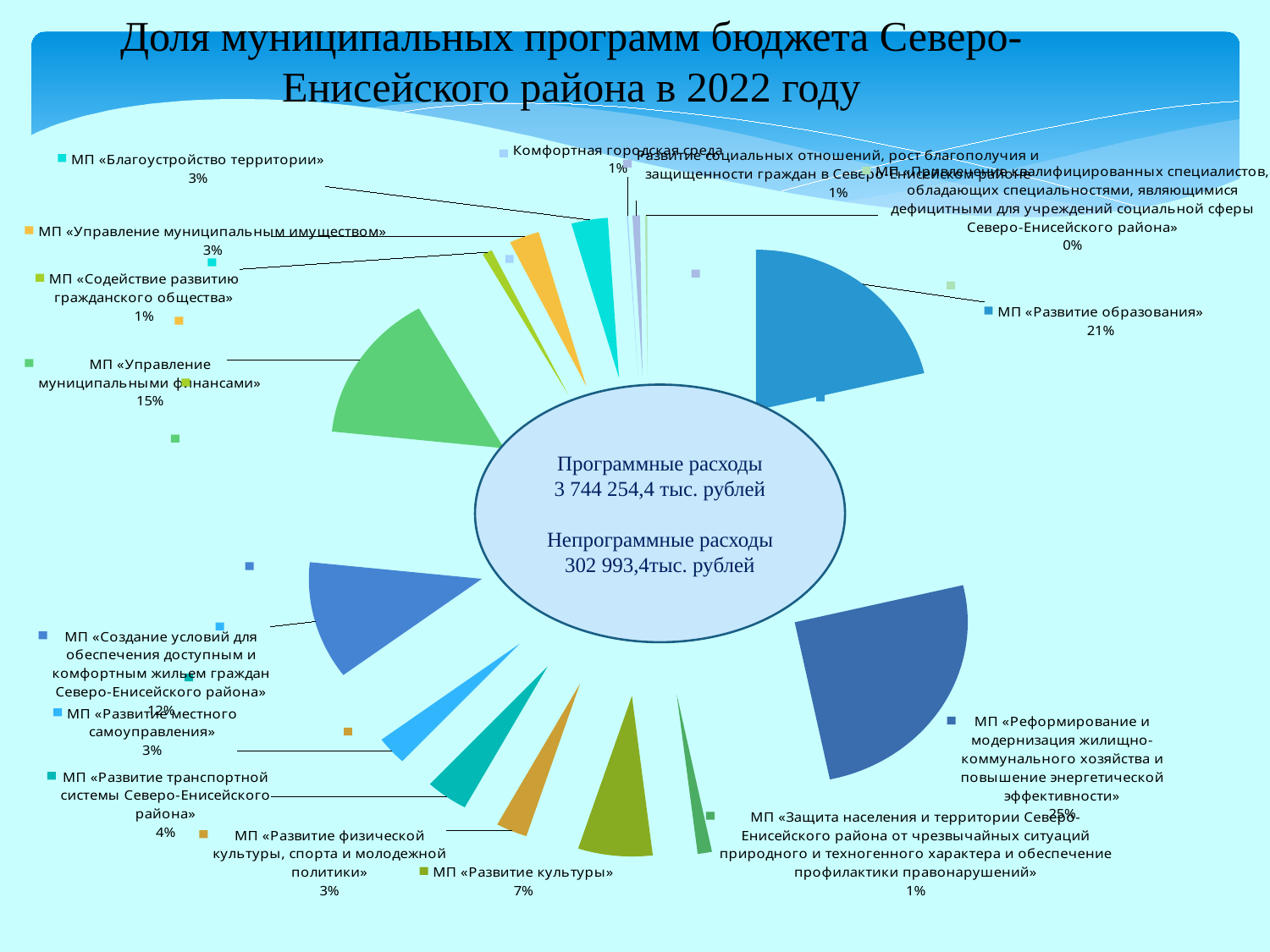
Which municipal program has the largest share of the budget? МП «Реформирование и модернизация жилищно-коммунального хозяйства и повышение энергетической эффективности» What amount of программные расходы is stated in the centre of the chart? 3 744 254,4 тыс. рублей Which municipal program has the smallest share, shown as 0%? МП «Привлечение квалифицированных специалистов, обладающих специальностями, являющимися дефицитными для учреждений социальной сферы Северо-Енисейского района» What share is shown for МП «Развитие транспортной системы Северо-Енисейского района»? 4% By how many percentage points does the share of МП «Реформирование и модернизация жилищно-коммунального хозяйства...» exceed that of МП «Развитие образования»? 4 percentage points What amount of непрограммные расходы is stated in the centre of the chart? 302 993,4 тыс. рублей Which has a larger share: МП «Развитие образования» or МП «Управление муниципальными финансами»? МП «Развитие образования» What share is shown for МП «Развитие культуры»? 7% What type of chart is shown on the slide? pie chart What share is shown for МП «Управление муниципальными финансами»? 15% What share of the budget does МП «Развитие образования» have? 21% How many municipal programs (slices) are shown in the pie chart? 15